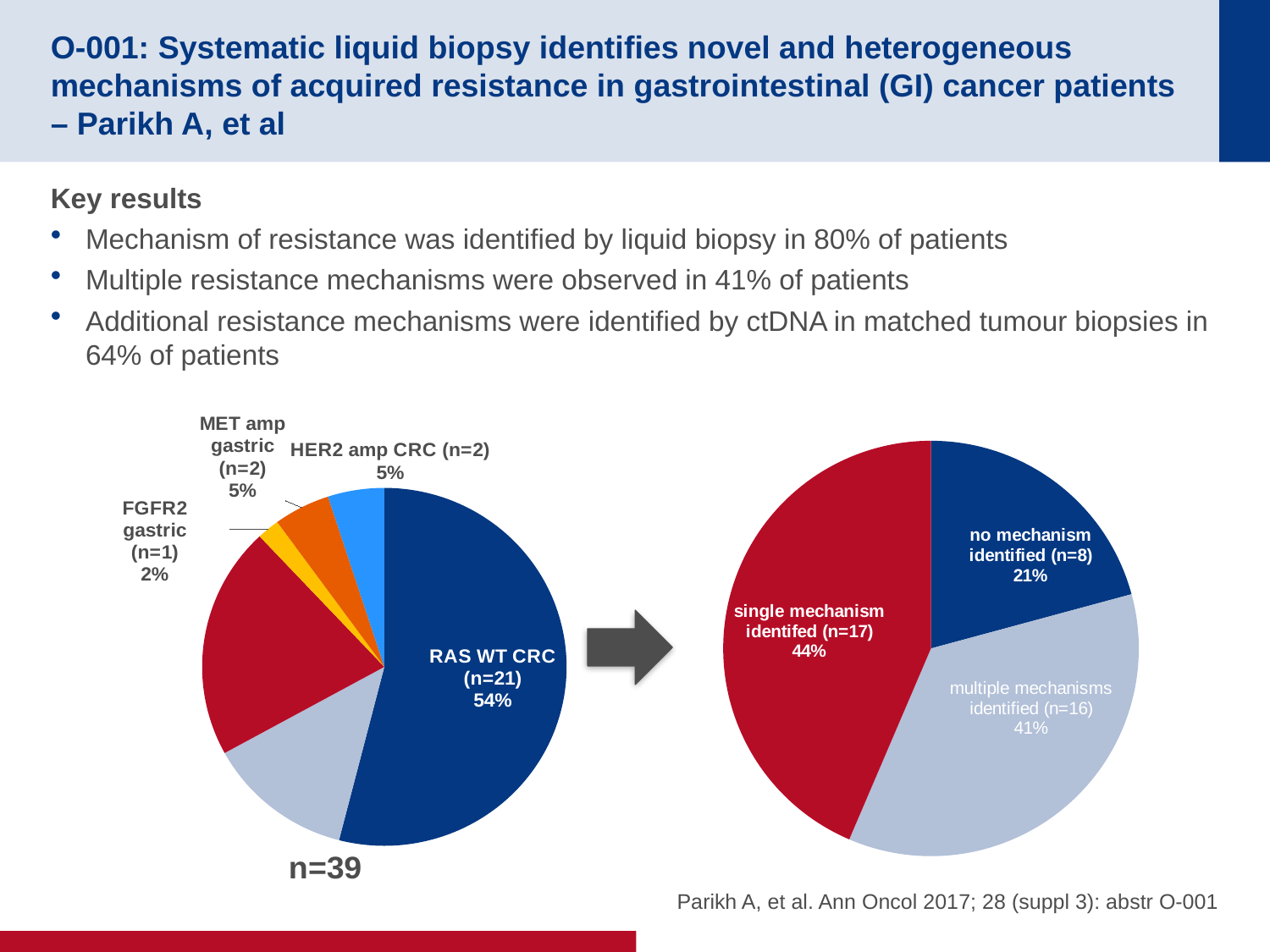
In the right pie chart, which category has the largest slice? single mechanism identified In the left pie chart, how many patients are in the FGFR2 gastric group? n=1 In the left pie chart, what share of patients are RAS WT CRC? 54% In the left pie chart, which is larger: the MET amp gastric slice or the FGFR2 gastric slice? MET amp gastric In the right pie chart, how many patients had multiple mechanisms identified? n=16 In the left pie chart, what is the difference in percentage points between the RAS WT CRC slice and the HER2 amp CRC slice? 49 percentage points How many slices does the right pie chart have? 3 In the right pie chart, which category has the smallest slice? no mechanism identified What is the total number of patients shown under the left pie chart? n=39 In the right pie chart, what percentage of patients had a single mechanism identified? 44% What type of charts are shown on the slide? Pie charts In the right pie chart, how many more patients had a single mechanism identified than multiple mechanisms identified? 1